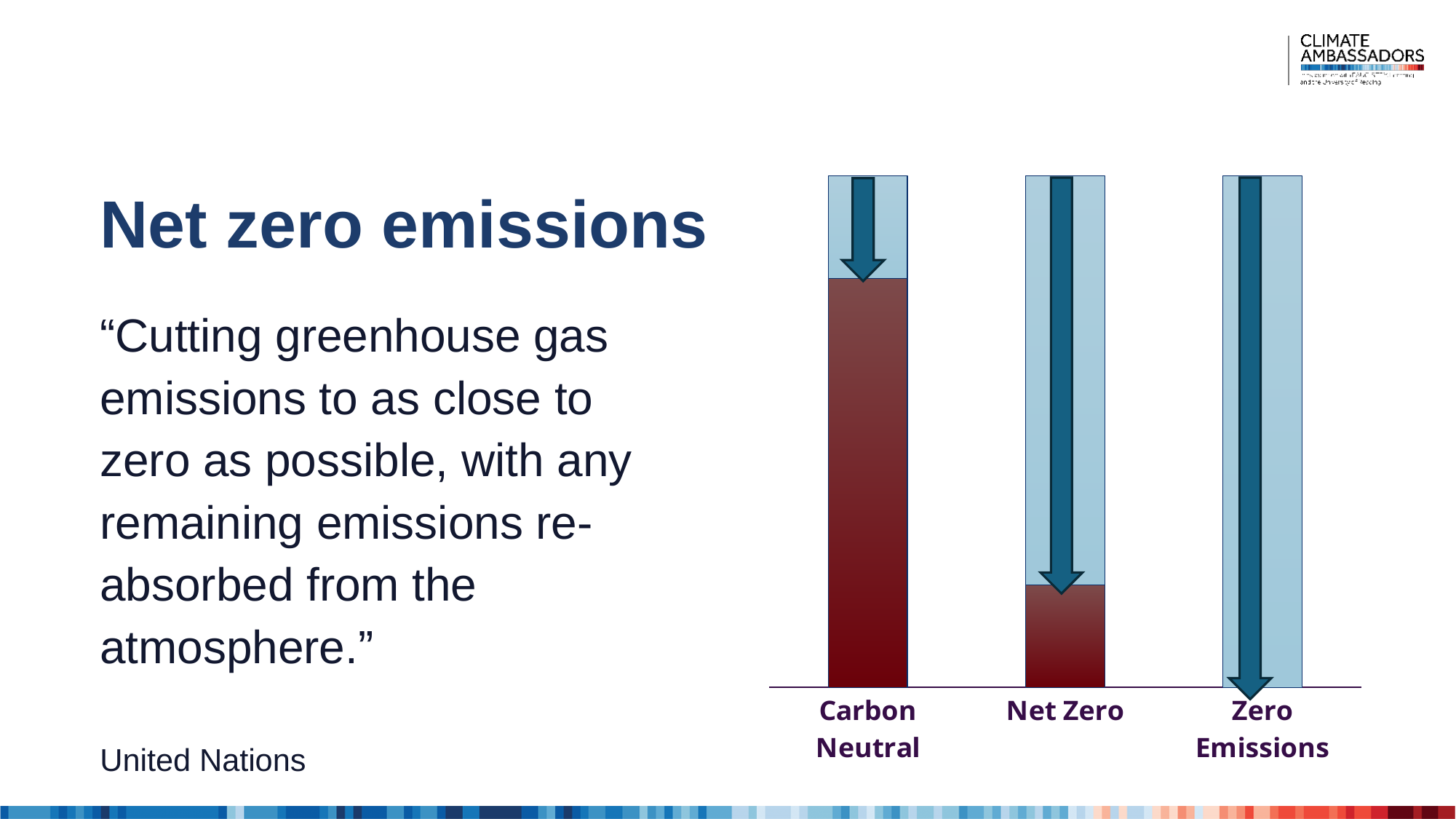
Do the dark red bars rise or fall from left to right across the categories? Fall How many categories are shown along the x axis of the chart? 3 Which has a taller dark red bar, Net Zero or Zero Emissions? Net Zero Which category has the tallest dark red bar? Carbon Neutral Which category has the longest downward arrow? Zero Emissions Which category has the shortest downward arrow? Carbon Neutral Which category has no dark red bar at all? Zero Emissions What is the label of the middle category on the x axis? Net Zero What kind of chart is shown on the right of the slide? Bar chart What are the three category labels on the x axis of the chart? Carbon Neutral, Net Zero, Zero Emissions Which has a taller dark red bar, Carbon Neutral or Net Zero? Carbon Neutral